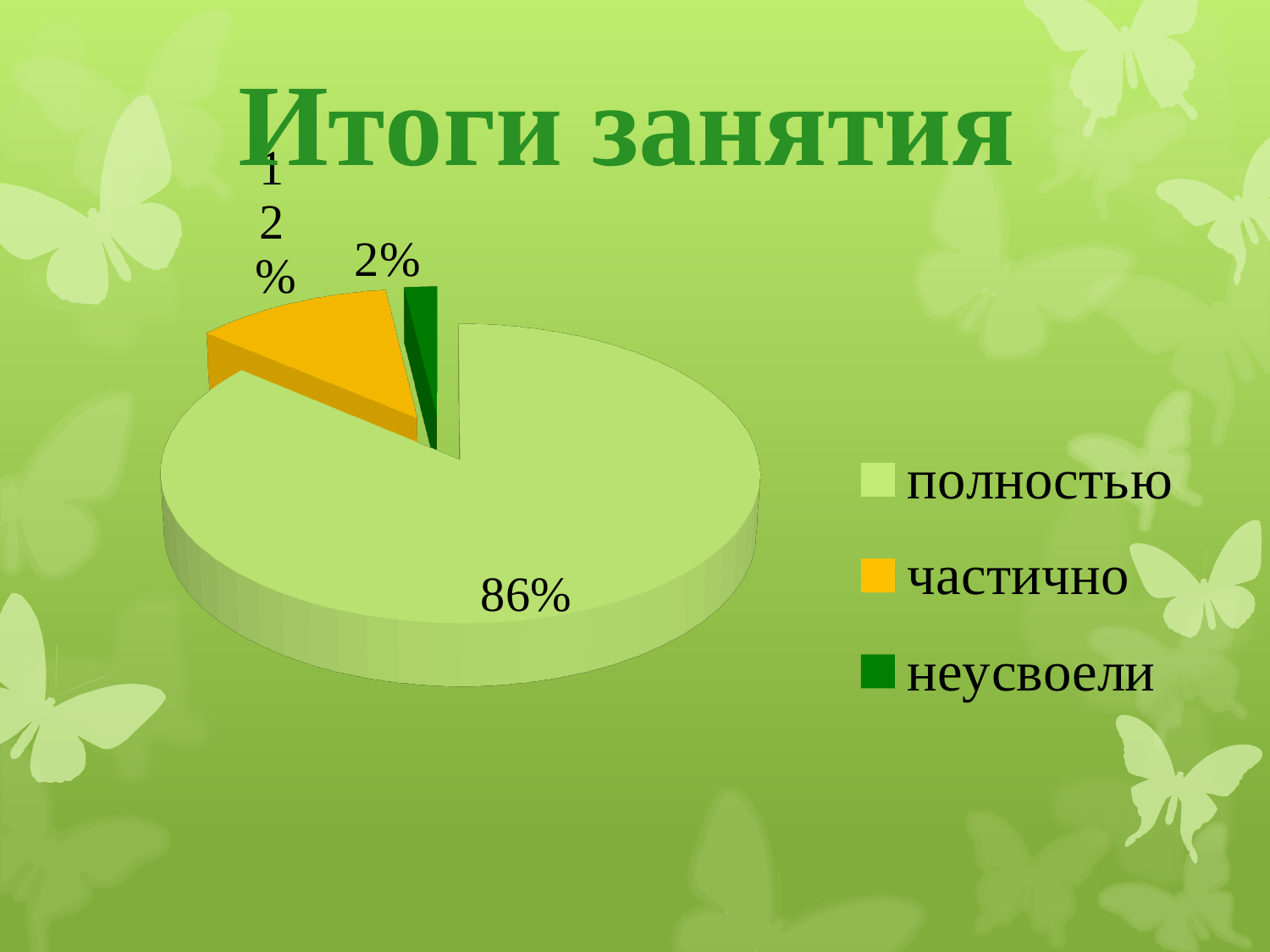
Which slice is larger, "частично" or "неусвоели"? частично What share of the pie does the "частично" slice have? 12% How many entries does the legend list? 3 What kind of chart is shown on the slide? pie chart Which category has the smallest slice of the pie? неусвоели What is the difference in percentage points between the "полностью" and "частично" slices? 74 What is the title of the slide containing the pie chart? Итоги занятия What share of the pie does the "неусвоели" slice have? 2% What share of the pie does the "полностью" slice have? 86% How many slices does the pie chart have? 3 What colour is the "частично" slice in the pie chart? yellow/orange Which category has the largest slice of the pie? полностью